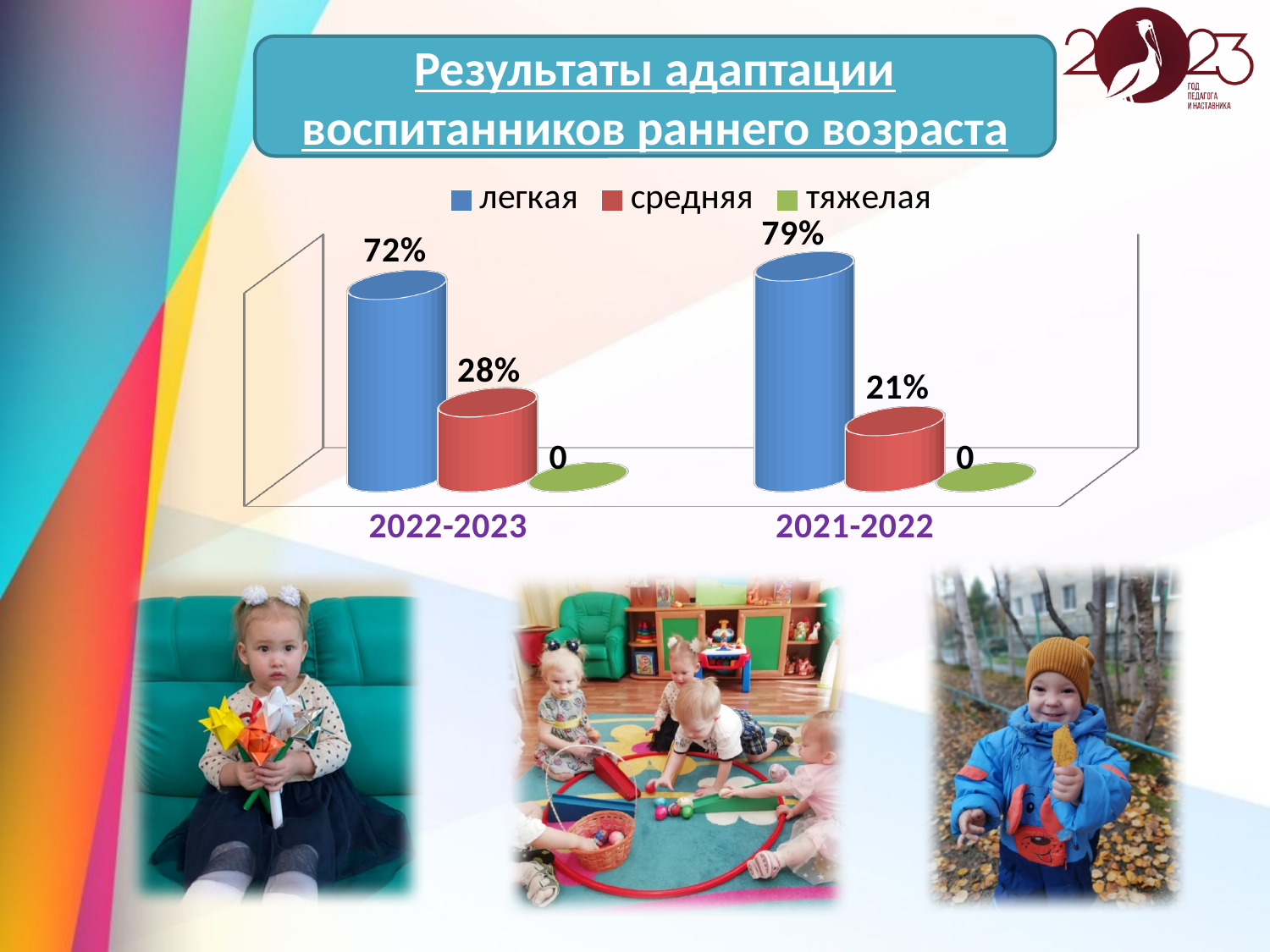
What is the value for средняя in 2021-2022? 21% What is the difference between легкая and средняя in 2022-2023? 44% Which series has the highest value in 2021-2022? легкая What is the value for легкая in 2021-2022? 79% What is the value for легкая in 2022-2023? 72% Which is larger: средняя in 2022-2023 or средняя in 2021-2022? средняя in 2022-2023 How many categories (periods) are shown on the x axis? 2 What is the difference between легкая in 2021-2022 and легкая in 2022-2023? 7% What kind of chart is shown on the slide? bar chart Which series has the lowest value in 2022-2023? тяжелая What is the value for тяжелая in 2022-2023? 0 How many series does the legend list? 3